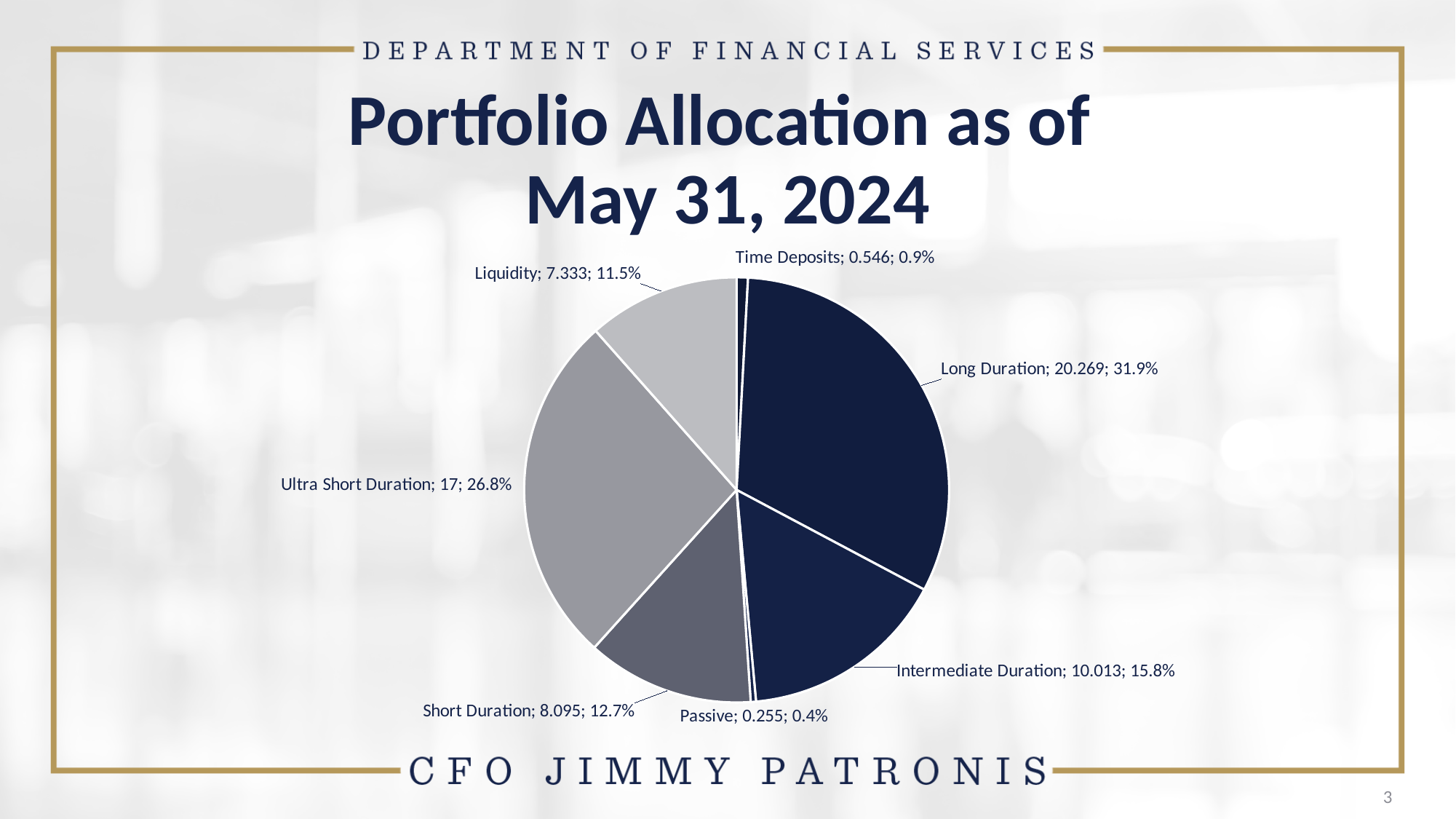
What is the title of the chart? Portfolio Allocation as of May 31, 2024 How many categories are shown in the pie chart? 7 What is the value for Intermediate Duration? 10.013 What is the value for Time Deposits? 0.546 What percentage share does Liquidity have? 11.5% Which is larger, Short Duration or Liquidity? Short Duration What type of chart is shown on the slide? pie chart What is the difference in value between Ultra Short Duration and Short Duration? 8.905 What is the value for Long Duration? 20.269 What percentage share does Ultra Short Duration have? 26.8% Which category has the smallest slice? Passive Which category has the largest slice? Long Duration